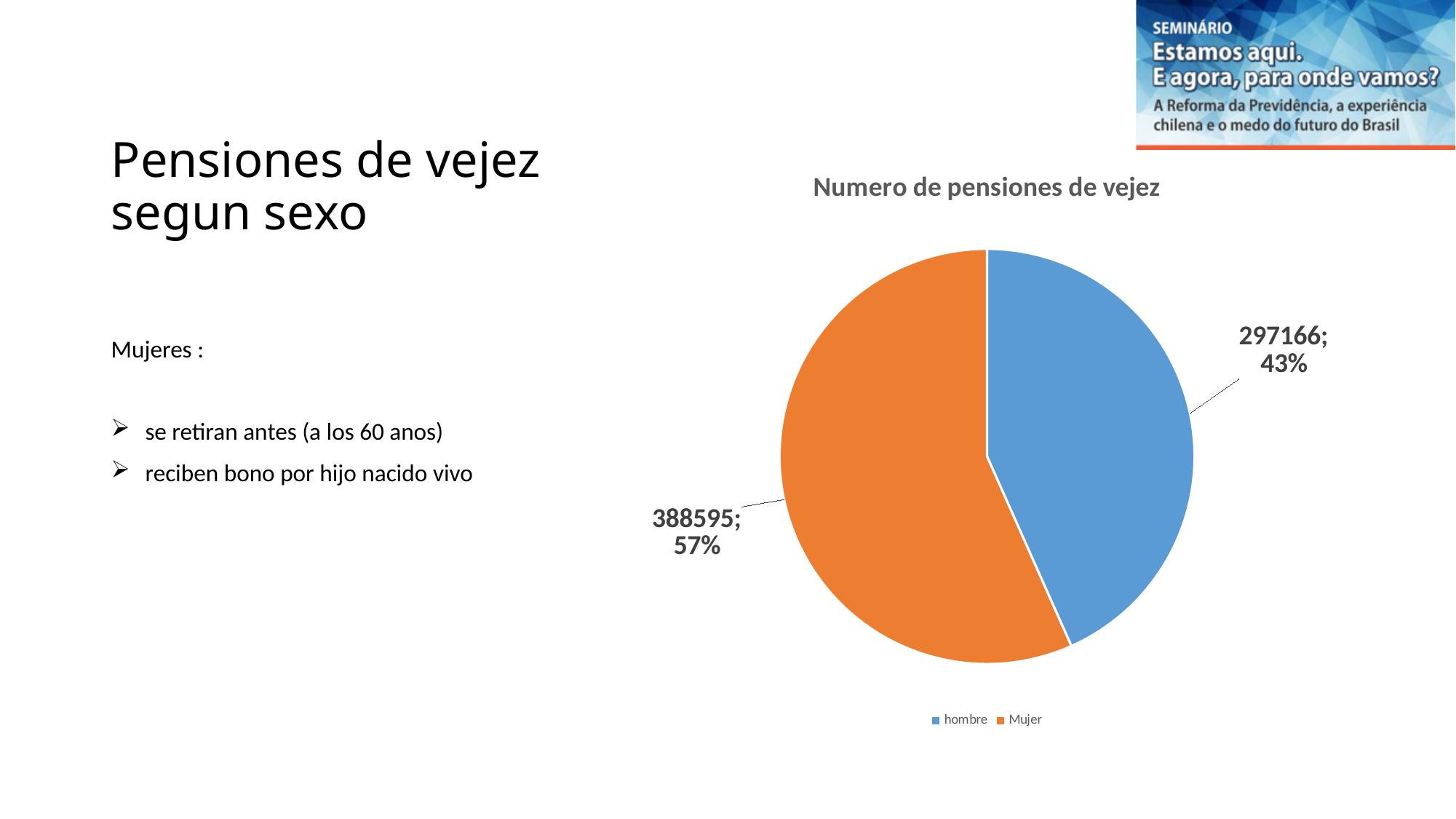
What is the value for hombre? 297166 Which colour represents Mujer in the chart? orange What kind of chart is shown on the slide? pie chart What is the difference between the value for Mujer and the value for hombre? 91429 Which is larger, the value for hombre or the value for Mujer? Mujer How many categories does the legend list? 2 Which category has the largest slice? Mujer What share of the pie does hombre represent? 43% What is the value for Mujer? 388595 What is the title of the chart? Numero de pensiones de vejez Which category has the smallest slice? hombre What share of the pie does Mujer represent? 57%